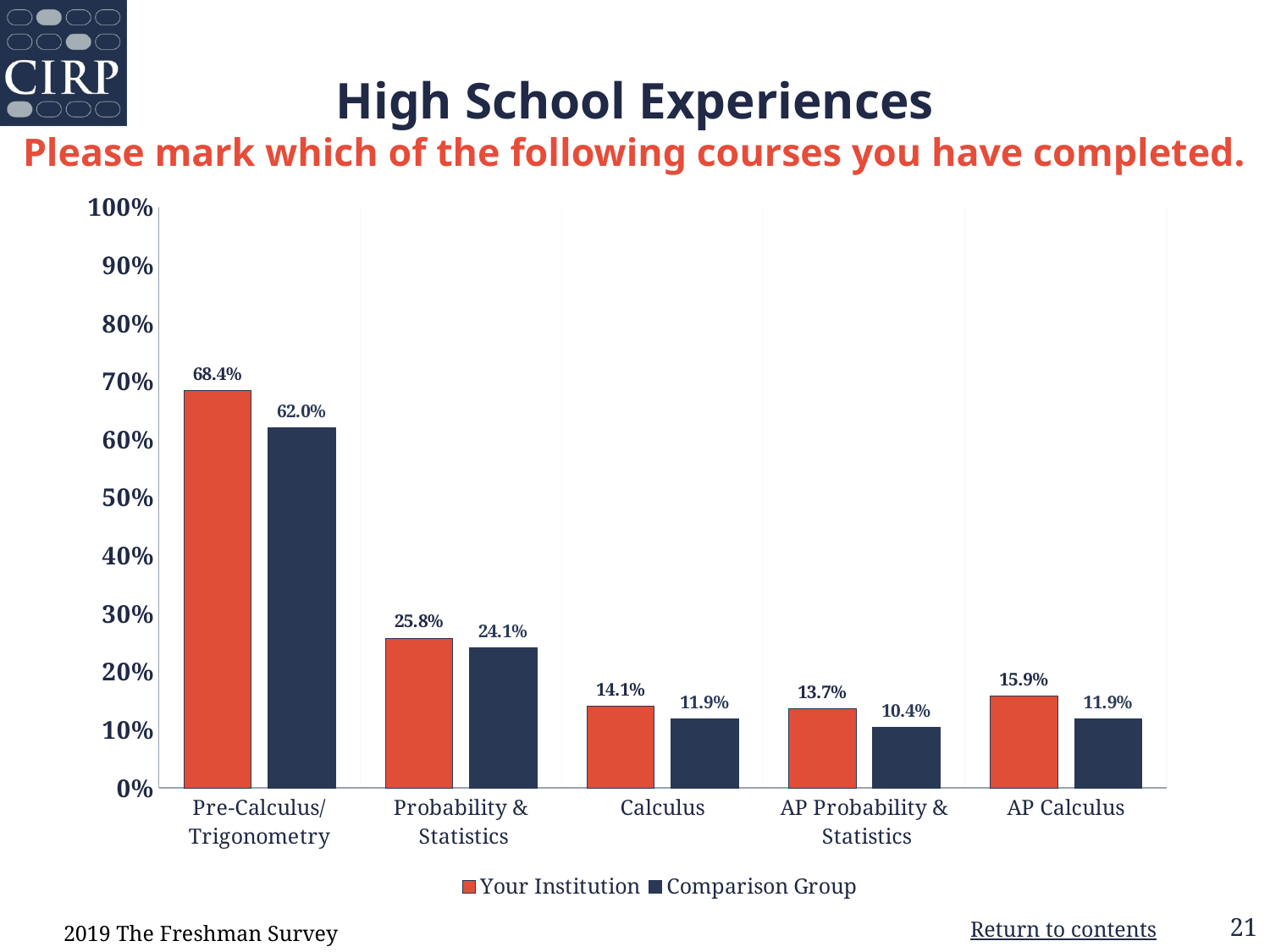
Which colour represents the Comparison Group in the chart? Dark navy blue What percentage of Your Institution students completed Pre-Calculus/Trigonometry? 68.4% What is the Your Institution value for AP Calculus? 15.9% How many series does the legend list? 2 What is the difference between Your Institution and Comparison Group for Calculus? 2.2% What is the Comparison Group value for AP Probability & Statistics? 10.4% How many courses are shown on the x axis? 5 Which course has the lowest Comparison Group value? AP Probability & Statistics What kind of chart is shown on the slide? Bar chart Which course has the highest Your Institution value? Pre-Calculus/Trigonometry For Probability & Statistics, which is larger: Your Institution or Comparison Group? Your Institution What is the difference between Your Institution and Comparison Group for Pre-Calculus/Trigonometry? 6.4%